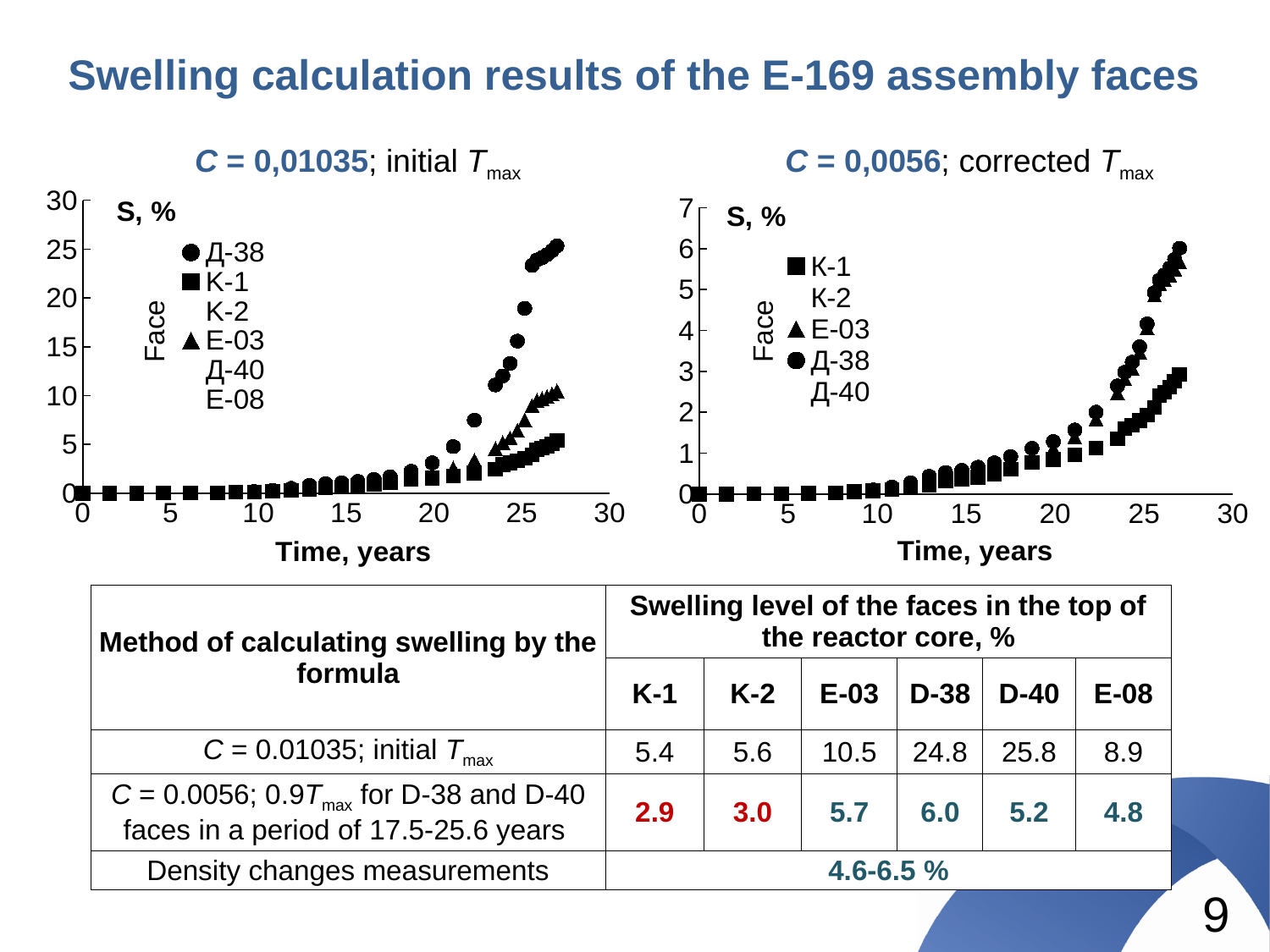
How many series does the legend of the right chart (C = 0,0056; corrected Tmax) list? 5 What is the x-axis label of the right chart (C = 0,0056; corrected Tmax)? Time, years How many series does the legend of the left chart (C = 0,01035; initial Tmax) list? 6 In the right chart (C = 0,0056; corrected Tmax), is the final value for K-1 greater or less than 5? less What kind of chart is the left chart (C = 0,01035; initial Tmax)? scatter chart In the left chart (C = 0,01035; initial Tmax), is the final value for Д-38 greater or less than 20? greater In the left chart (C = 0,01035; initial Tmax), which series has the larger value at the end of the time range, Д-38 or K-1? Д-38 In the right chart (C = 0,0056; corrected Tmax), is the final value for Д-38 greater or less than 5? greater In the right chart (C = 0,0056; corrected Tmax), do the swelling values rise or fall as time increases? rise In the right chart (C = 0,0056; corrected Tmax), which series has the lowest swelling value at the end of the time range? K-1